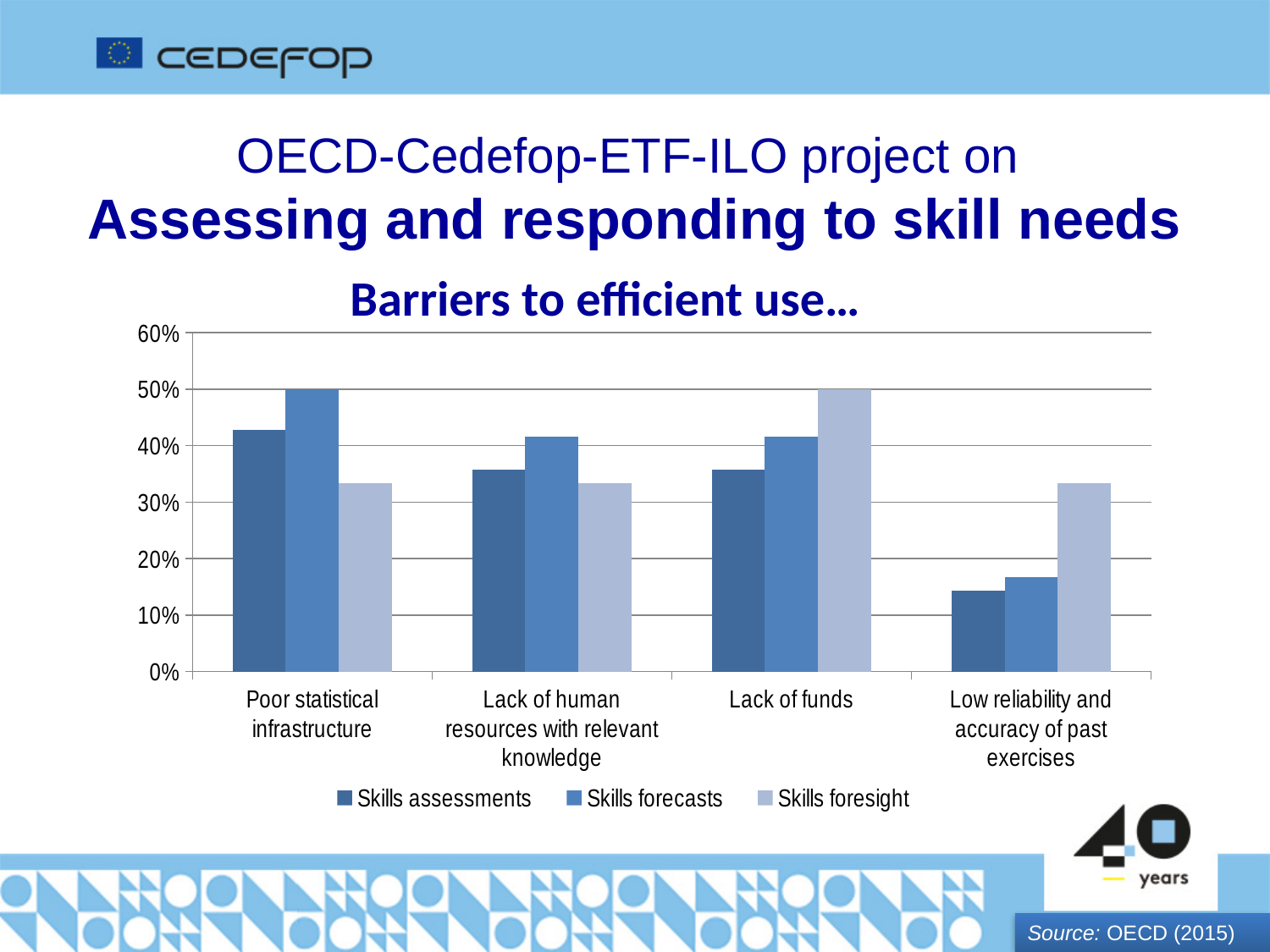
How many series does the legend list? 3 Is the value for Skills forecasts for Low reliability and accuracy of past exercises greater or less than 20%? less What is the value for Skills foresight for Lack of funds? 50% For Lack of funds, which is larger: Skills assessments or Skills foresight? Skills foresight How many barrier categories are shown on the x axis? 4 What is the title of the chart? Barriers to efficient use… What is the value for Skills forecasts for Poor statistical infrastructure? 50% Which category has the lowest value for Skills assessments? Low reliability and accuracy of past exercises Which series is shown in the lightest blue in the legend? Skills foresight Is the value for Skills assessments for Poor statistical infrastructure greater or less than 40%? greater What kind of chart is shown on the slide? bar chart Which category has the highest value for Skills foresight? Lack of funds